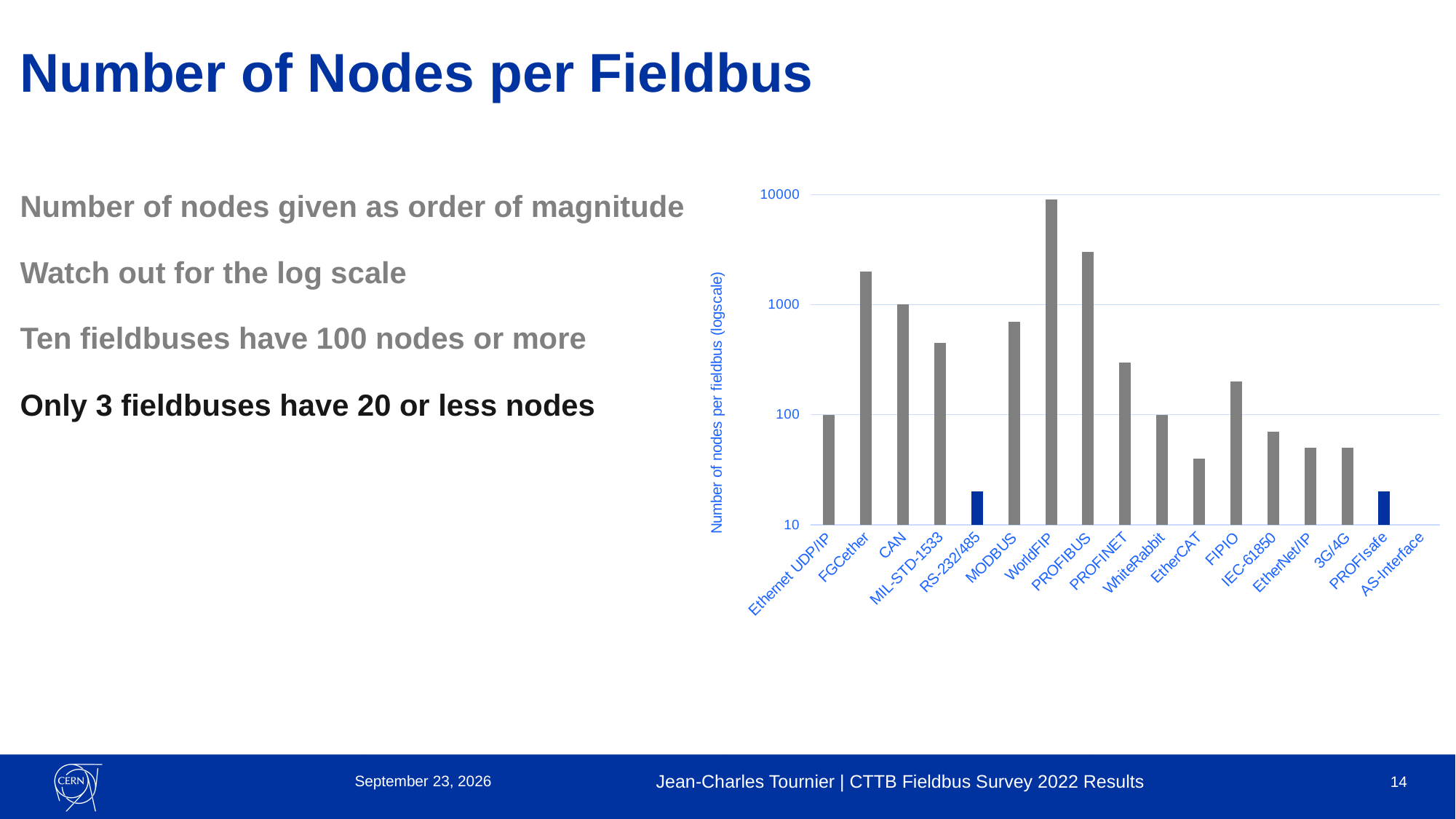
Is the value for FGCether greater or less than 1000? greater What is the number of nodes for Ethernet UDP/IP? 100 What is the label of the chart's y axis? Number of nodes per fieldbus (logscale) How many fieldbus categories are listed on the x axis of the chart? 17 Which has more nodes, WorldFIP or PROFIBUS? WorldFIP What kind of chart is shown on the slide? bar chart Which fieldbus has the highest number of nodes in the chart? WorldFIP Which has more nodes, PROFINET or FIPIO? PROFINET What is the number of nodes for CAN? 1000 Is the value for MODBUS greater or less than 1000? less Is the value for FIPIO greater or less than 100? greater